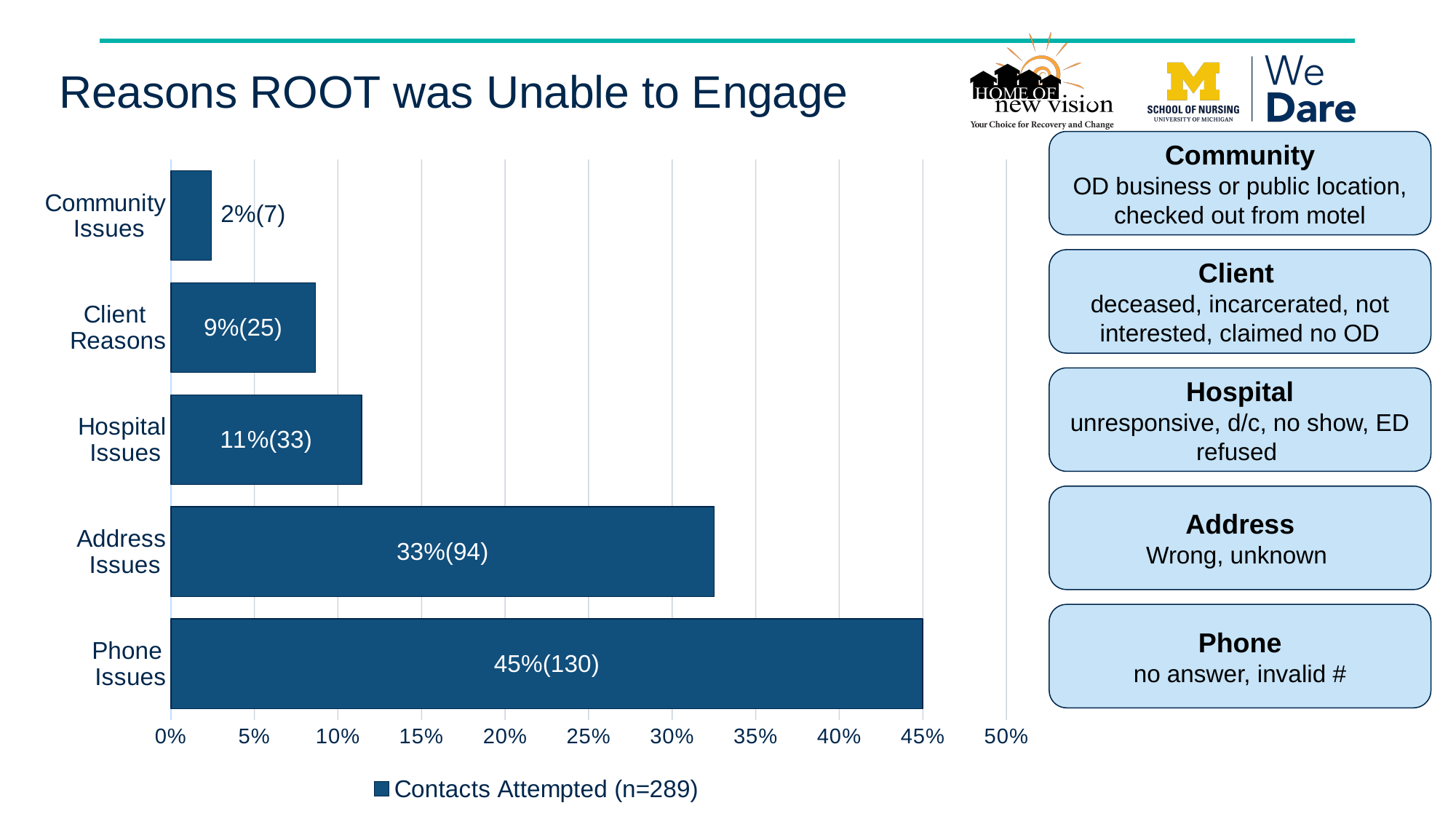
What is the data label shown for Address Issues? 33%(94) What is the data label shown for Community Issues? 2%(7) What is the legend entry for the series in the chart? Contacts Attempted (n=289) Which is larger, the value for Client Reasons or the value for Hospital Issues? Hospital Issues Which category has the highest value? Phone Issues What is the data label shown for Hospital Issues? 11%(33) What is the difference in percentage points between Phone Issues and Address Issues? 12% How many more contacts are counted for Hospital Issues than for Client Reasons? 8 Which category has the lowest value? Community Issues What is the data label shown for Phone Issues? 45%(130) What kind of chart is shown on the slide? Bar chart How many categories are shown in the chart? 5